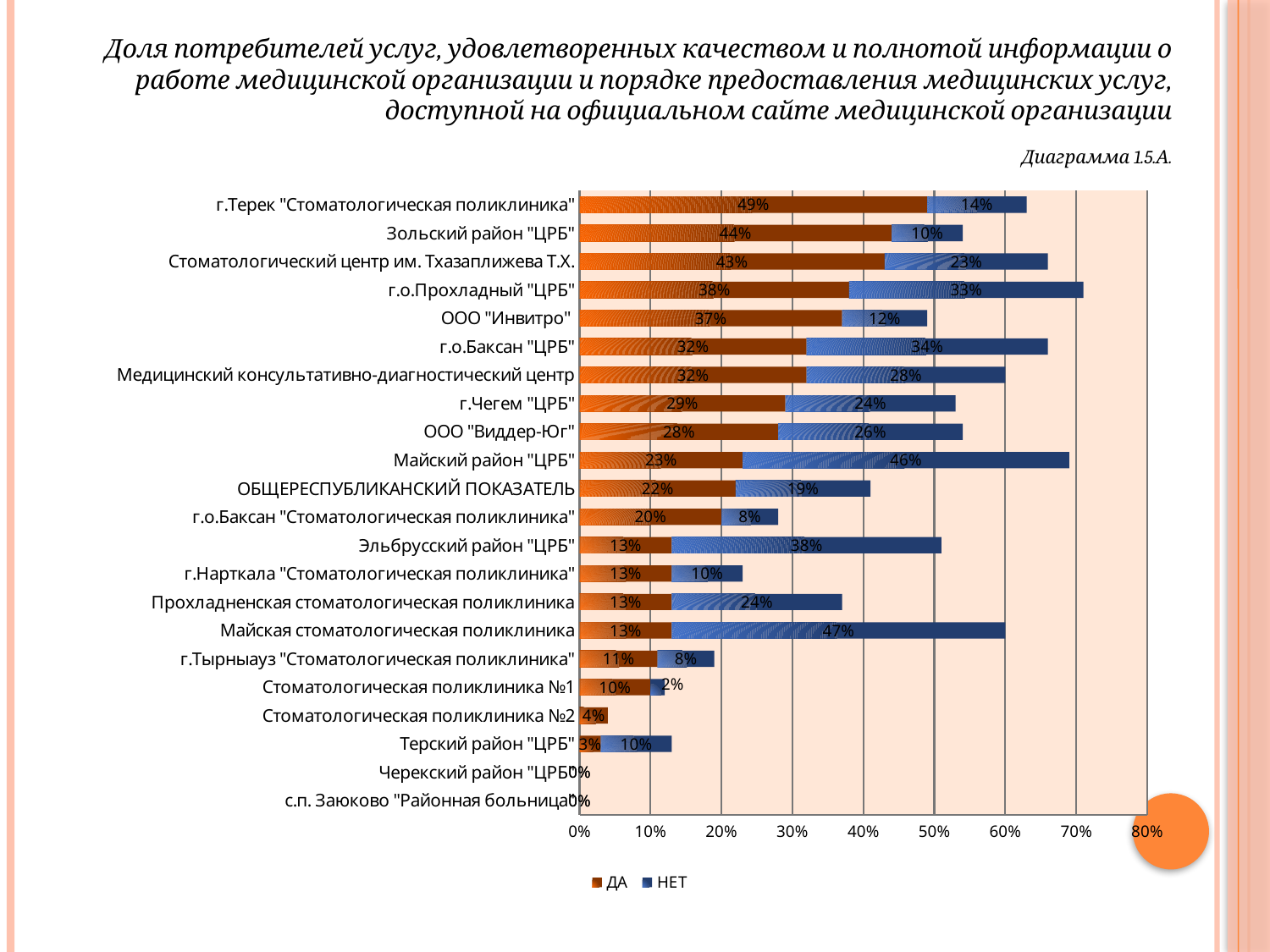
What is the difference between the ДА and НЕТ values for г.Терек "Стоматологическая поликлиника"? 35% What is the total of the stacked bar for Зольский район "ЦРБ"? 54% How many series does the legend list? 2 Which series is shown in orange in the legend? ДА Which category has the highest ДА value? г.Терек "Стоматологическая поликлиника" How many categories are shown on the chart? 22 What kind of chart is shown on the slide? Stacked bar chart What is the ДА value for ОБЩЕРЕСПУБЛИКАНСКИЙ ПОКАЗАТЕЛЬ? 22% Which is larger for г.о.Баксан "ЦРБ": the ДА value or the НЕТ value? НЕТ What is the ДА value for г.Терек "Стоматологическая поликлиника"? 49% Is the total of the stacked bar for Стоматологический центр им. Тхазаплижева Т.Х. greater or less than 60%? greater What is the НЕТ value for Майский район "ЦРБ"? 46%